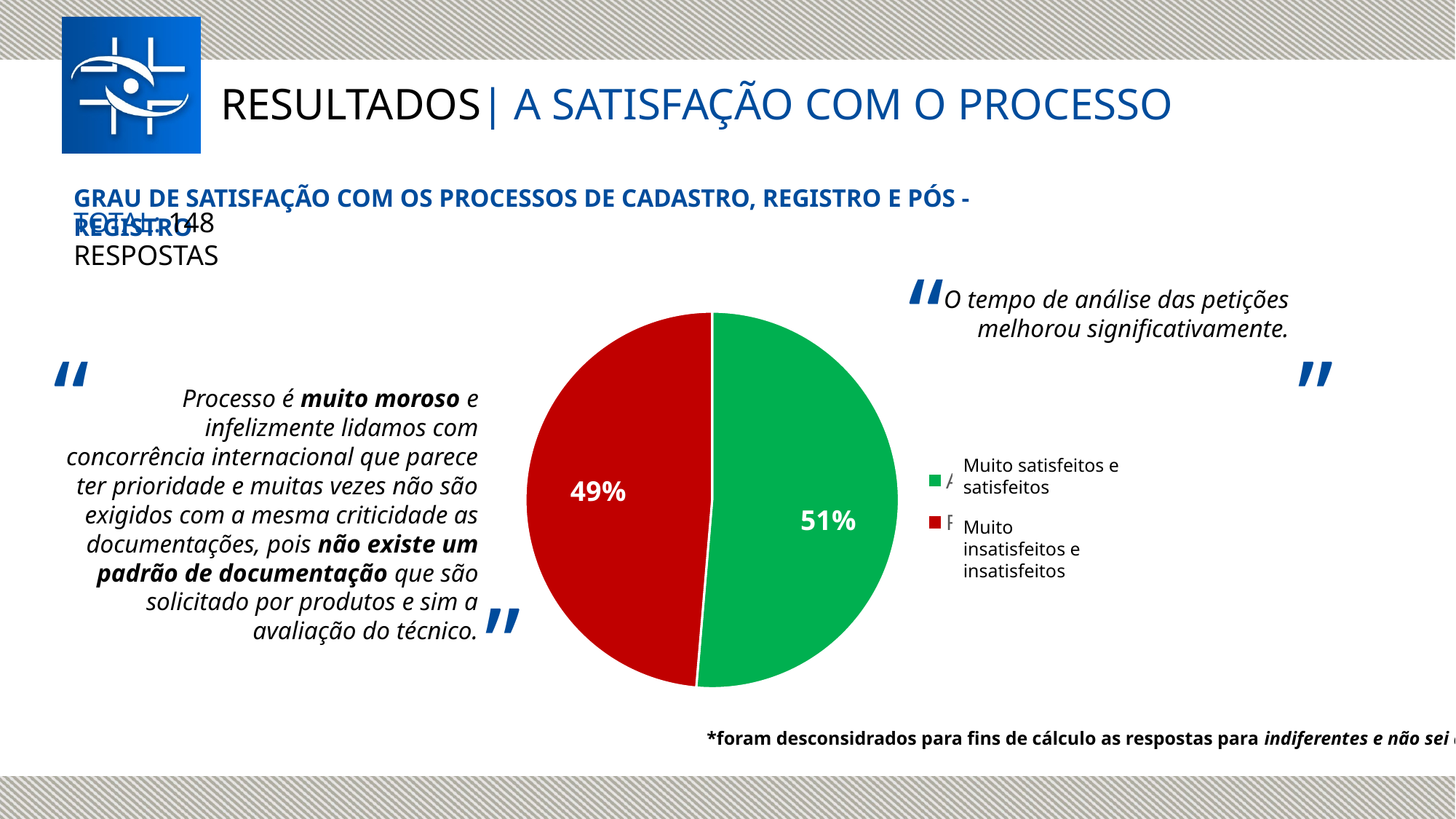
What kind of chart is shown on the slide? Pie chart What is the total number of responses stated for the chart? 148 Which category has the largest share in the pie chart? Muito satisfeitos e satisfeitos How many slices does the pie chart have? 2 Which category has the smallest share in the pie chart? Muito insatisfeitos e insatisfeitos What percentage of the pie chart is shown for the red slice (Muito insatisfeitos e insatisfeitos)? 49% Which slice of the pie chart is larger, the green one or the red one? The green one (51%) Is the share for the red slice greater or less than 50%? less What is the difference in percentage points between the two slices of the pie chart? 2 percentage points What colour represents 'Muito insatisfeitos e insatisfeitos' in the pie chart? Red What colour represents 'Muito satisfeitos e satisfeitos' in the pie chart? Green What percentage of the pie chart is shown for the green slice (Muito satisfeitos e satisfeitos)? 51%